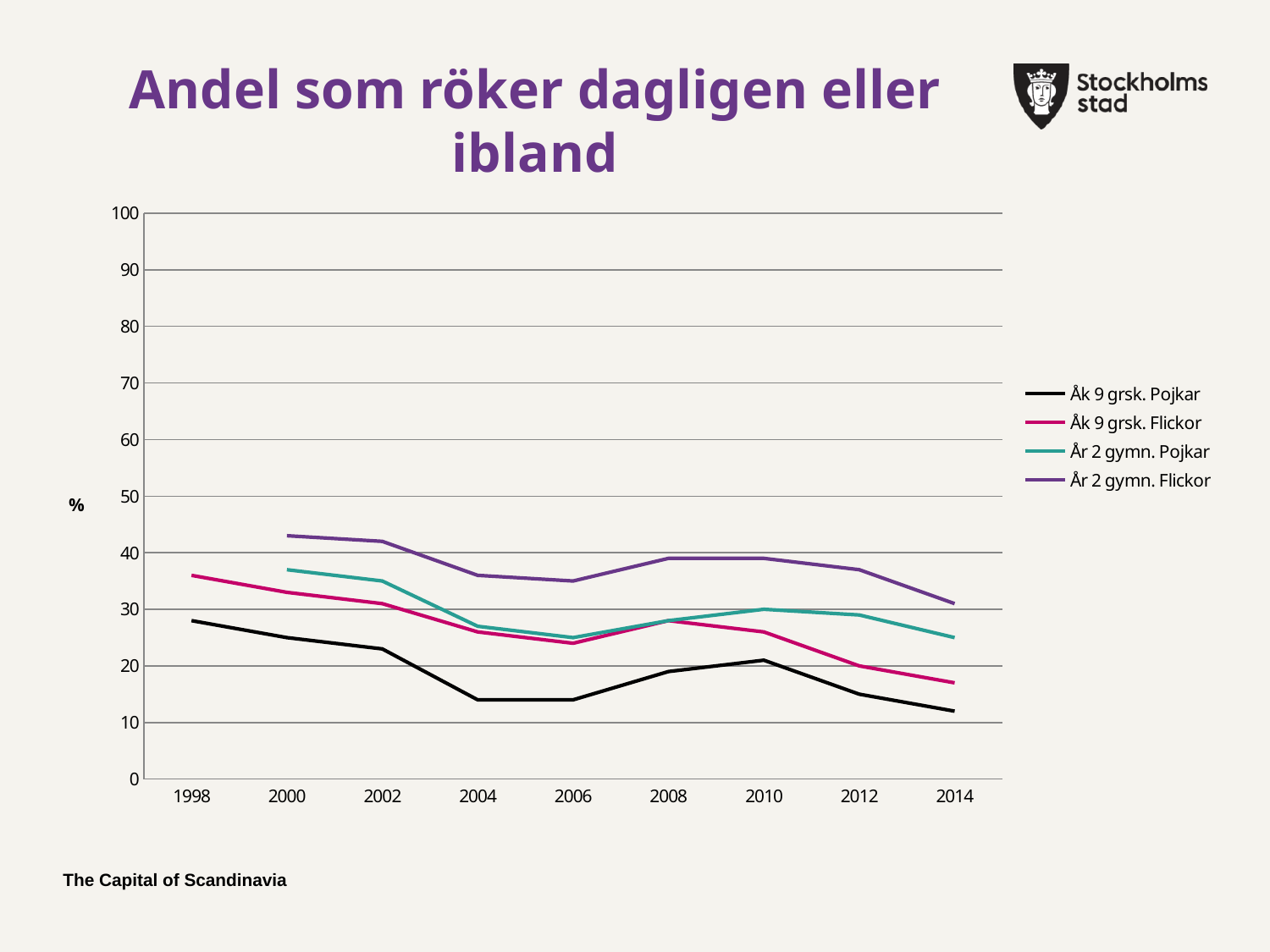
Does the Åk 9 grsk. Pojkar line overall rise or fall from 1998 to 2014? fall Is the value for Åk 9 grsk. Flickor in 2014 greater or less than 20? less Which series has the lowest value in 2014? Åk 9 grsk. Pojkar In 1998, which is larger: Åk 9 grsk. Flickor or Åk 9 grsk. Pojkar? Åk 9 grsk. Flickor Is the value for År 2 gymn. Flickor in 2000 greater or less than 40? greater Is the value for Åk 9 grsk. Pojkar in 1998 greater or less than 20? greater How many series does the legend list? 4 Which series has the highest value in 2014? År 2 gymn. Flickor What is the title of the chart on the slide? Andel som röker dagligen eller ibland What kind of chart is shown on the slide? line chart How many years are shown on the x axis? 9